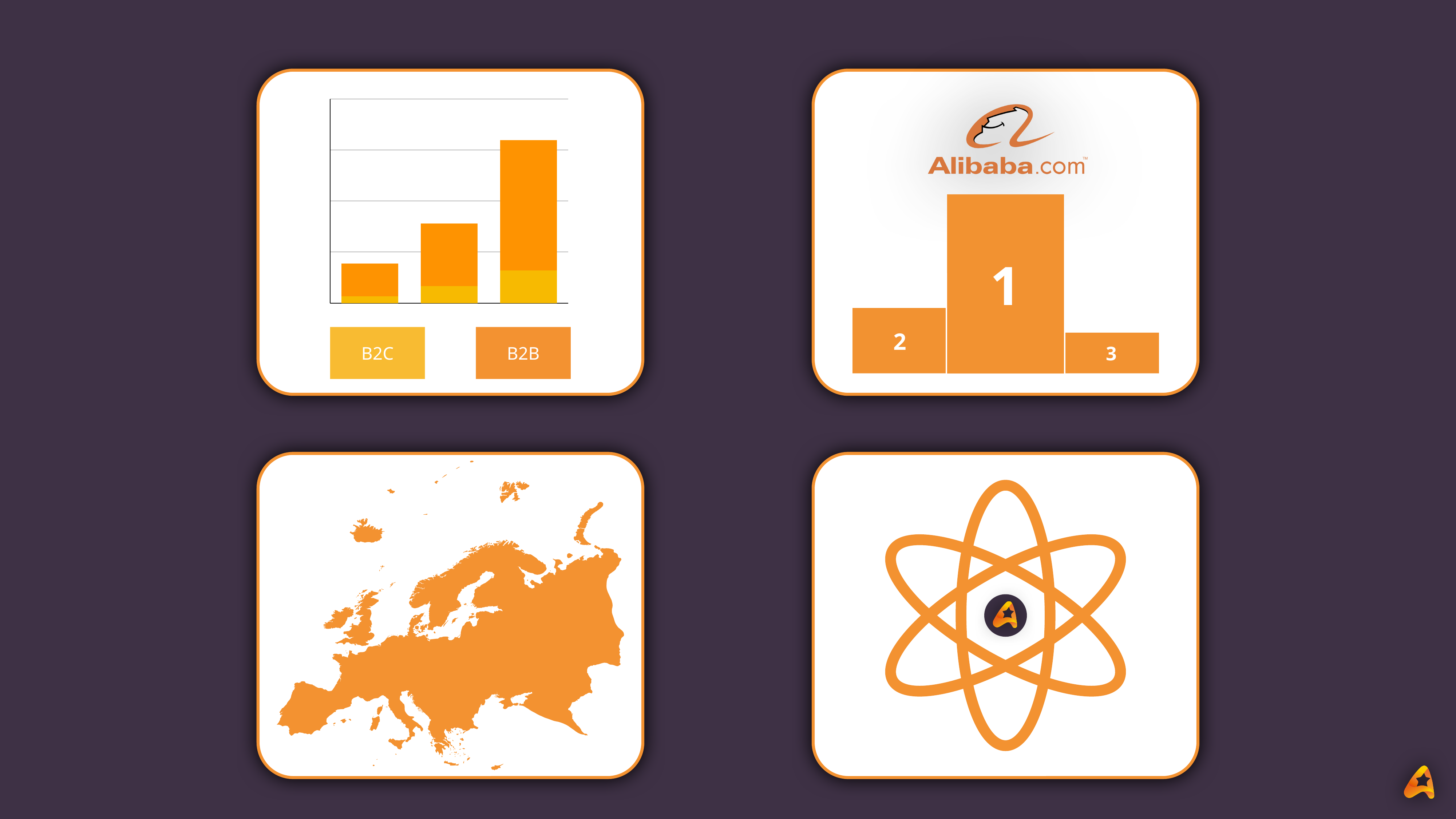
In the top-left bar chart, which bar has the highest total: the left, middle or right one? right In the top-left bar chart, which series is shown in the lighter yellow colour? B2C In the leftmost bar of the top-left chart, which segment is larger, B2C or B2B? B2B How many bars are plotted in the top-left bar chart? 3 In the top-left bar chart, is the middle bar taller or shorter than the rightmost bar? shorter In the top-left bar chart, which bar has the lowest total: the left, middle or right one? left In the rightmost bar of the top-left chart, which segment is larger, B2C or B2B? B2B What are the two legend entries of the top-left bar chart? B2C and B2B What kind of chart is shown in the top-left panel of the slide? stacked bar chart In the top-left bar chart, do the bar totals rise or fall from left to right? rise How many series does the legend of the top-left bar chart list? 2